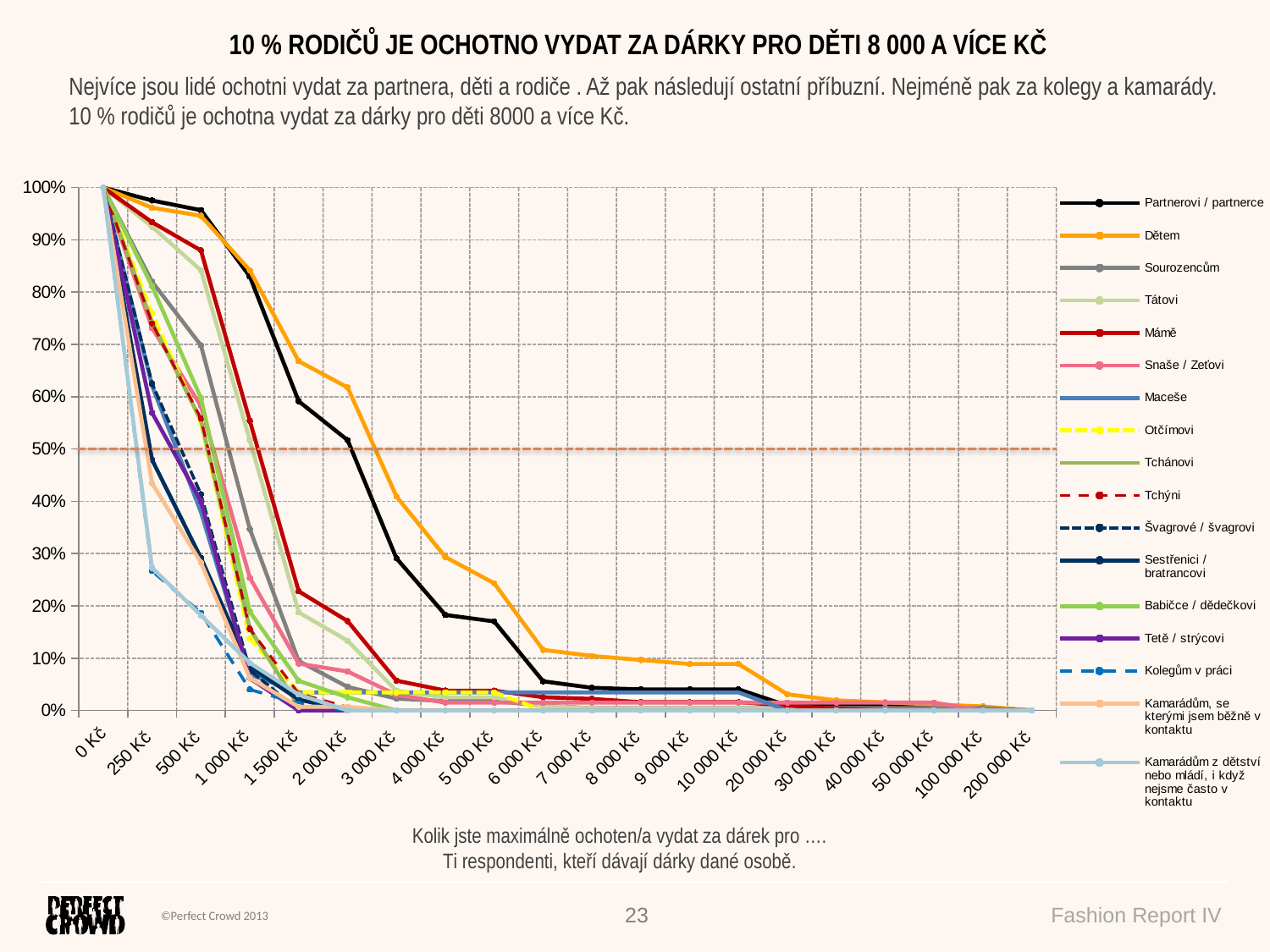
What kind of chart is shown on the slide? line chart Do the values for Dětem rise or fall as the amount on the x axis increases? fall Which series has the highest value at 3 000 Kč? Dětem Is the value for Partnerovi / partnerce at 3 000 Kč greater or less than 50%? less Is the value for Mámě at 500 Kč greater or less than 80%? greater Is the value for Dětem at 2 000 Kč greater or less than 50%? greater How many categories are shown on the x axis? 20 At 1 000 Kč, which is larger: the value for Dětem or the value for Mámě? Dětem What is the value for Partnerovi / partnerce at 200 000 Kč? 0% How many series does the legend list? 17 What is the value for Dětem at 0 Kč? 100%